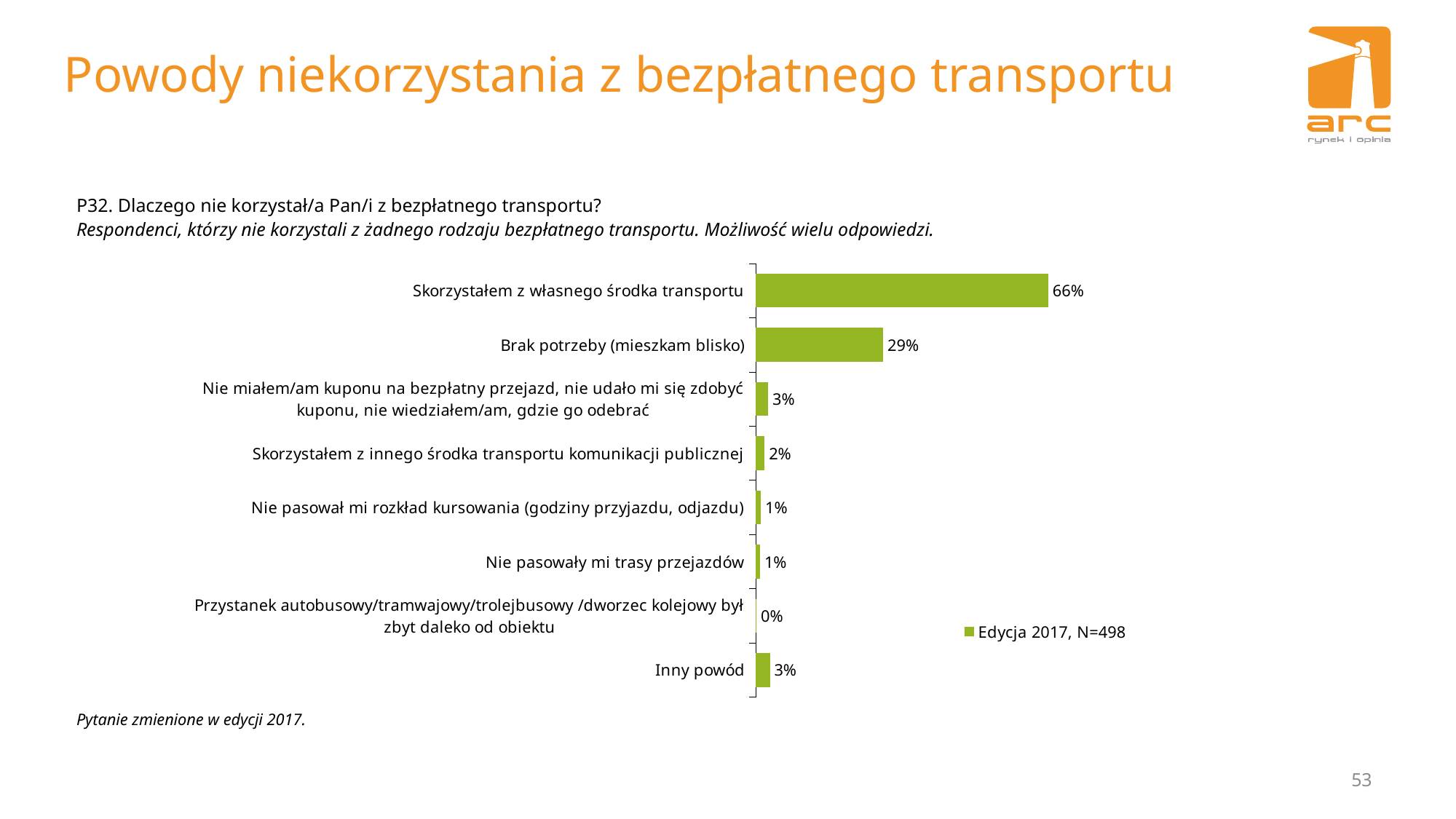
What is the value for "Skorzystałem z innego środka transportu komunikacji publicznej"? 2% What is the value for "Brak potrzeby (mieszkam blisko)"? 29% Which category has the lowest value? Przystanek autobusowy/tramwajowy/trolejbusowy /dworzec kolejowy był zbyt daleko od obiektu What is the value for "Skorzystałem z własnego środka transportu"? 66% What is the value for "Inny powód"? 3% What kind of chart is shown on the slide? Bar chart How many categories are shown in the chart? 8 What is the legend entry of the chart? Edycja 2017, N=498 What is the difference between "Skorzystałem z własnego środka transportu" and "Brak potrzeby (mieszkam blisko)"? 37% Which is larger: "Brak potrzeby (mieszkam blisko)" or "Inny powód"? Brak potrzeby (mieszkam blisko) Which category has the highest value? Skorzystałem z własnego środka transportu How many series does the legend list? 1